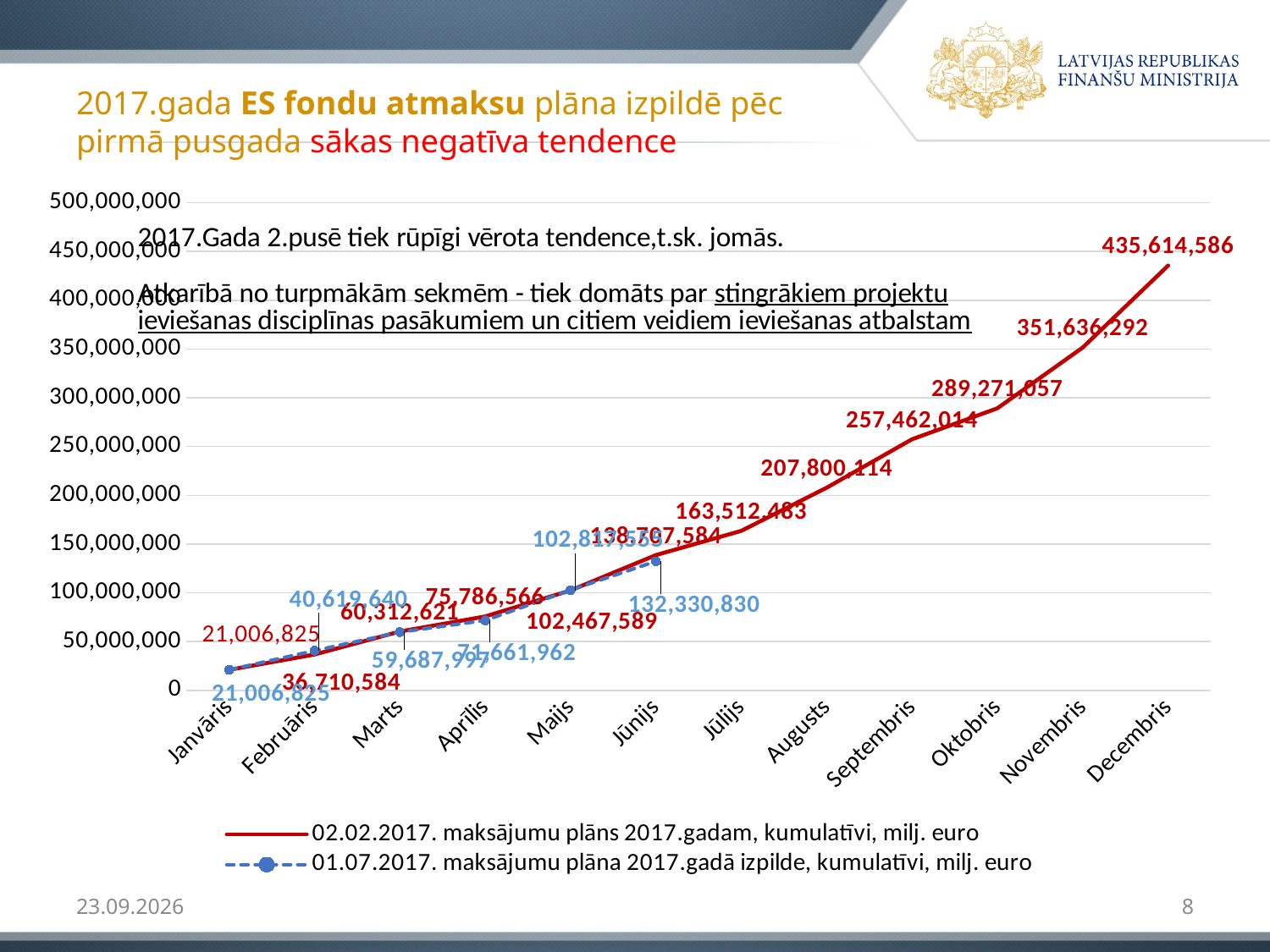
What is the value of the plan series (02.02.2017. maksājumu plāns) for Decembris? 435,614,586 Is the plan value for Novembris greater or less than 400,000,000? less What is the value of the execution series (01.07.2017. izpilde) for Jūnijs? 132,330,830 What is the difference between the plan value and the execution value for Jūnijs? 6,376,754 How many months are shown on the x axis? 12 How many series does the legend list? 2 What is the value of the plan series for Jūnijs? 138,707,584 What kind of chart is shown on the slide? line chart In which month does the plan series reach its highest value? Decembris For Februāris, which is larger: the plan value or the execution value? the execution value (40,619,640) Does the plan series rise or fall from Janvāris to Decembris? rise What is the execution series value for Aprīlis? 71,661,962